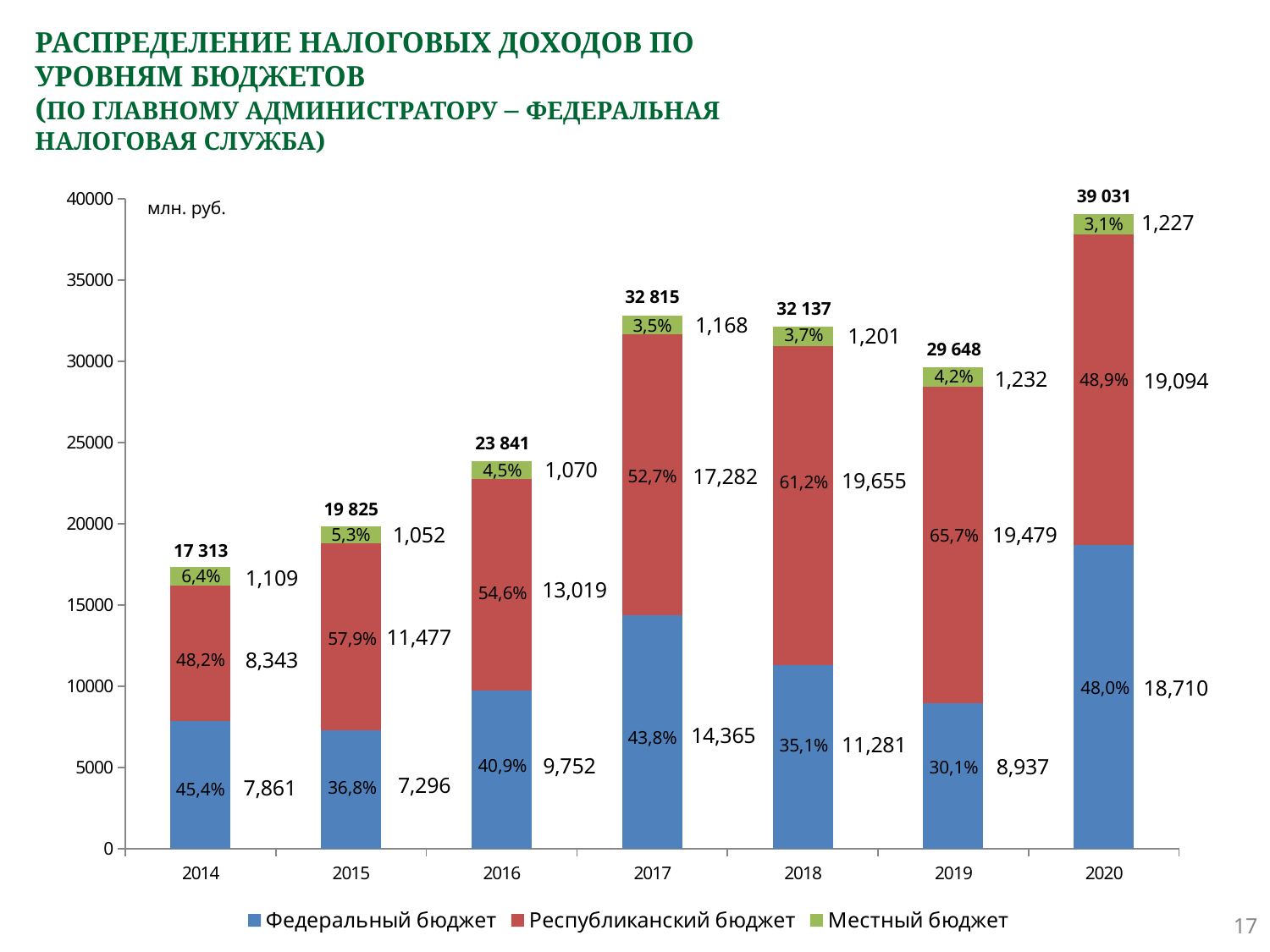
What is the value for Республиканский бюджет in 2018? 19,655 How many series does the legend list? 3 What is the unit of measurement shown on the chart? млн. руб. Which year has the lowest total tax revenue? 2014 How many years are shown on the x axis? 7 What percentage share does Республиканский бюджет have in 2019? 65,7% Which year has the highest total tax revenue? 2020 What is the value for Федеральный бюджет in 2017? 14,365 What is the value for Местный бюджет in 2014? 1,109 Which is larger: the Федеральный бюджет value in 2020 or in 2019? 2020 What type of chart is shown on the slide? Stacked bar chart What is the total tax revenue shown above the bar for 2020? 39 031